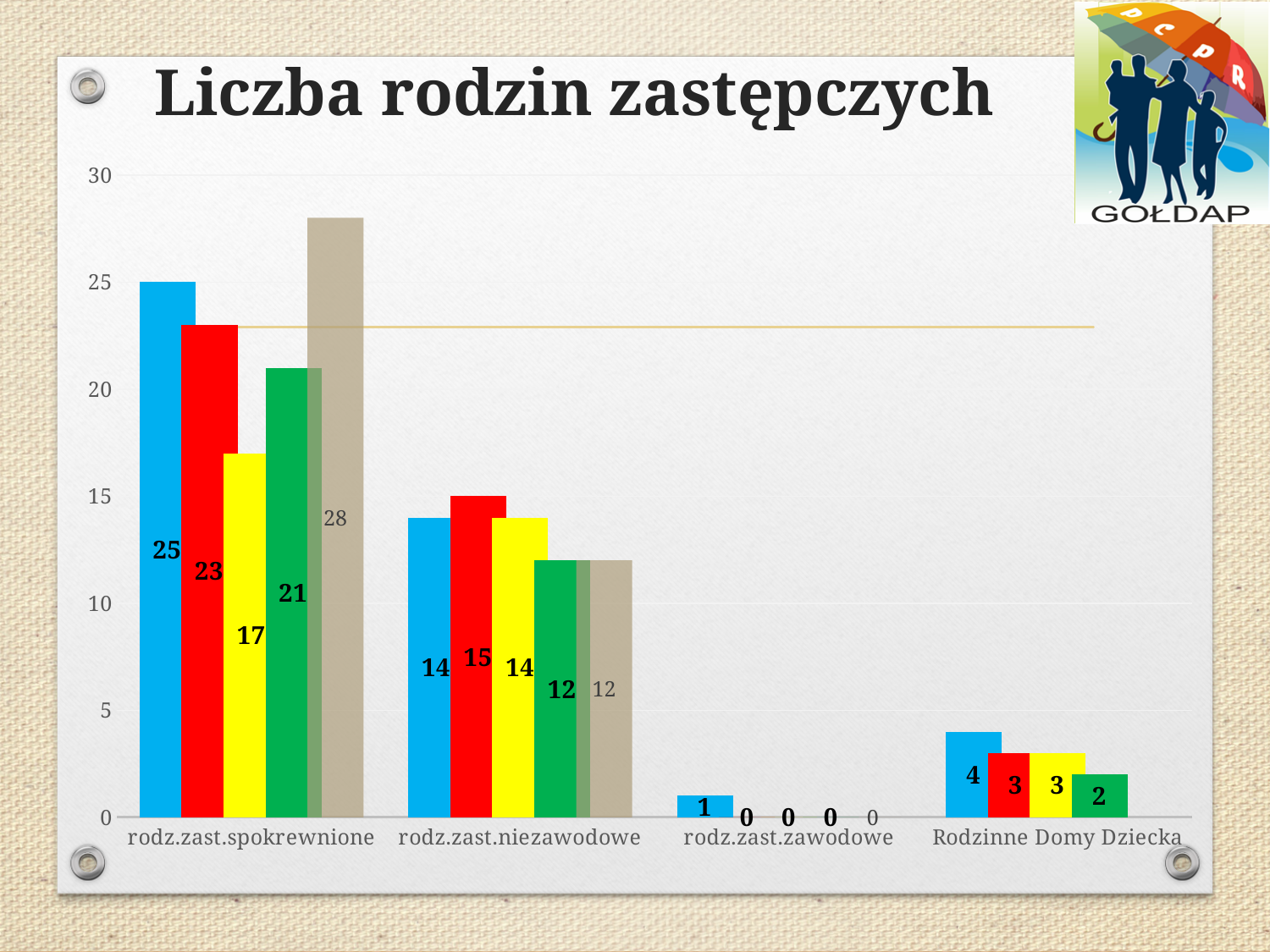
How many categories are shown on the x axis? 4 What is the difference between the blue bar and the yellow bar for rodz.zast.spokrewnione? 8 Which bar is the lowest in the rodz.zast.spokrewnione group? the yellow bar, 17 What is the value of the blue bar for rodz.zast.zawodowe? 1 What is the value of the tan (beige) bar for rodz.zast.spokrewnione? 28 Which bar is the highest in the rodz.zast.spokrewnione group? the tan (beige) bar, 28 Is the value of the blue bar for rodz.zast.spokrewnione greater or less than 20? greater What is the value of the green bar for Rodzinne Domy Dziecka? 2 What is the title of the chart? Liczba rodzin zastępczych Which is larger for rodz.zast.niezawodowe, the red bar or the green bar? the red bar What is the value of the red bar for rodz.zast.niezawodowe? 15 What kind of chart is shown on the slide? bar chart